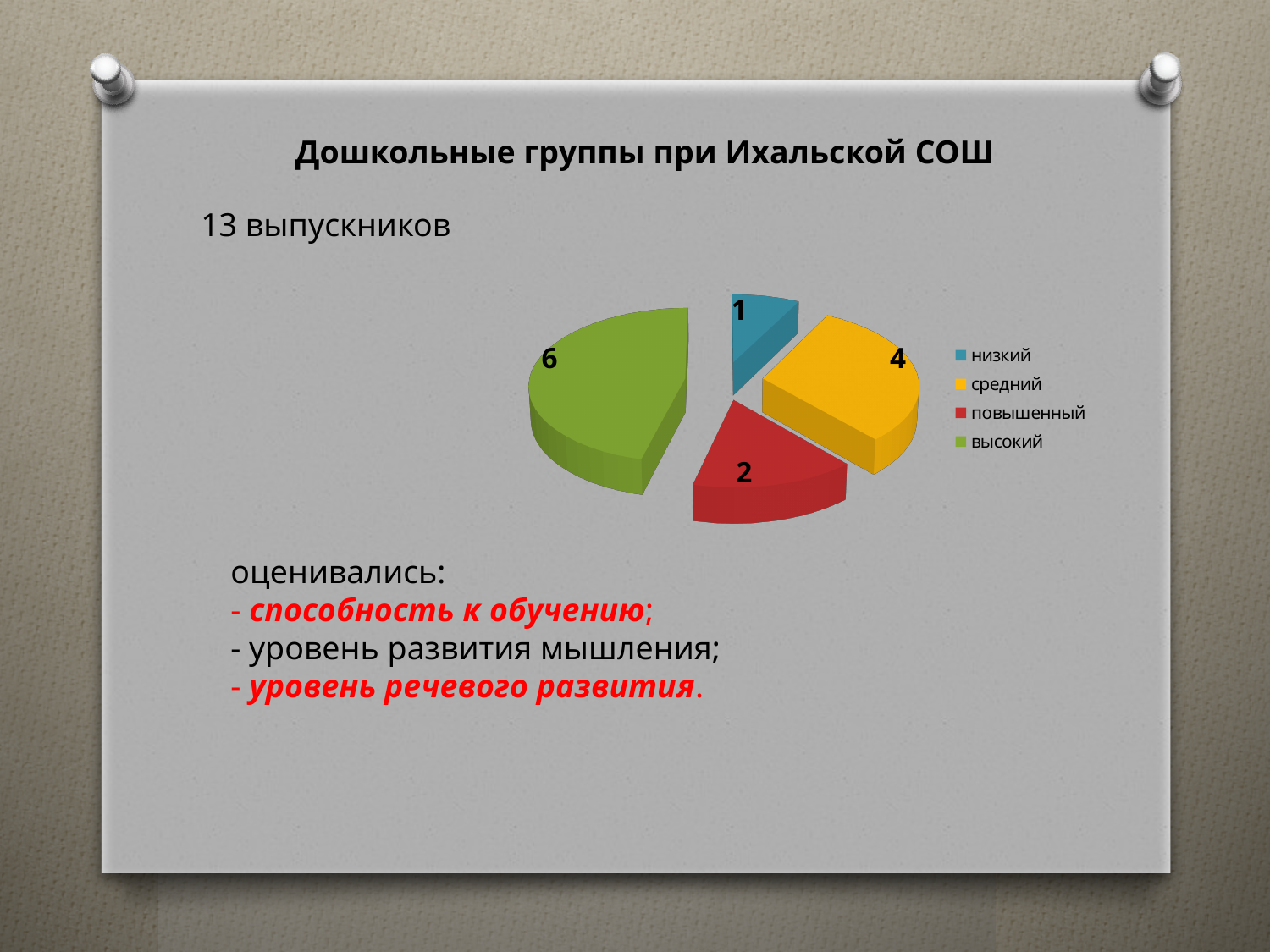
What is the value for the "повышенный" slice? 2 What is the value for the "средний" slice? 4 What is the difference between the values for "высокий" and "средний"? 2 What is the value for the "низкий" slice? 1 How many slices does the pie chart have? 4 What colour is the "высокий" slice in the legend? green What is the value for the "высокий" slice? 6 Which category has the largest slice? высокий What kind of chart is shown on the slide? pie chart Which category has the smallest slice? низкий Which is larger, the value for "средний" or the value for "повышенный"? средний What share of the pie does the "средний" slice represent? 4 of 13